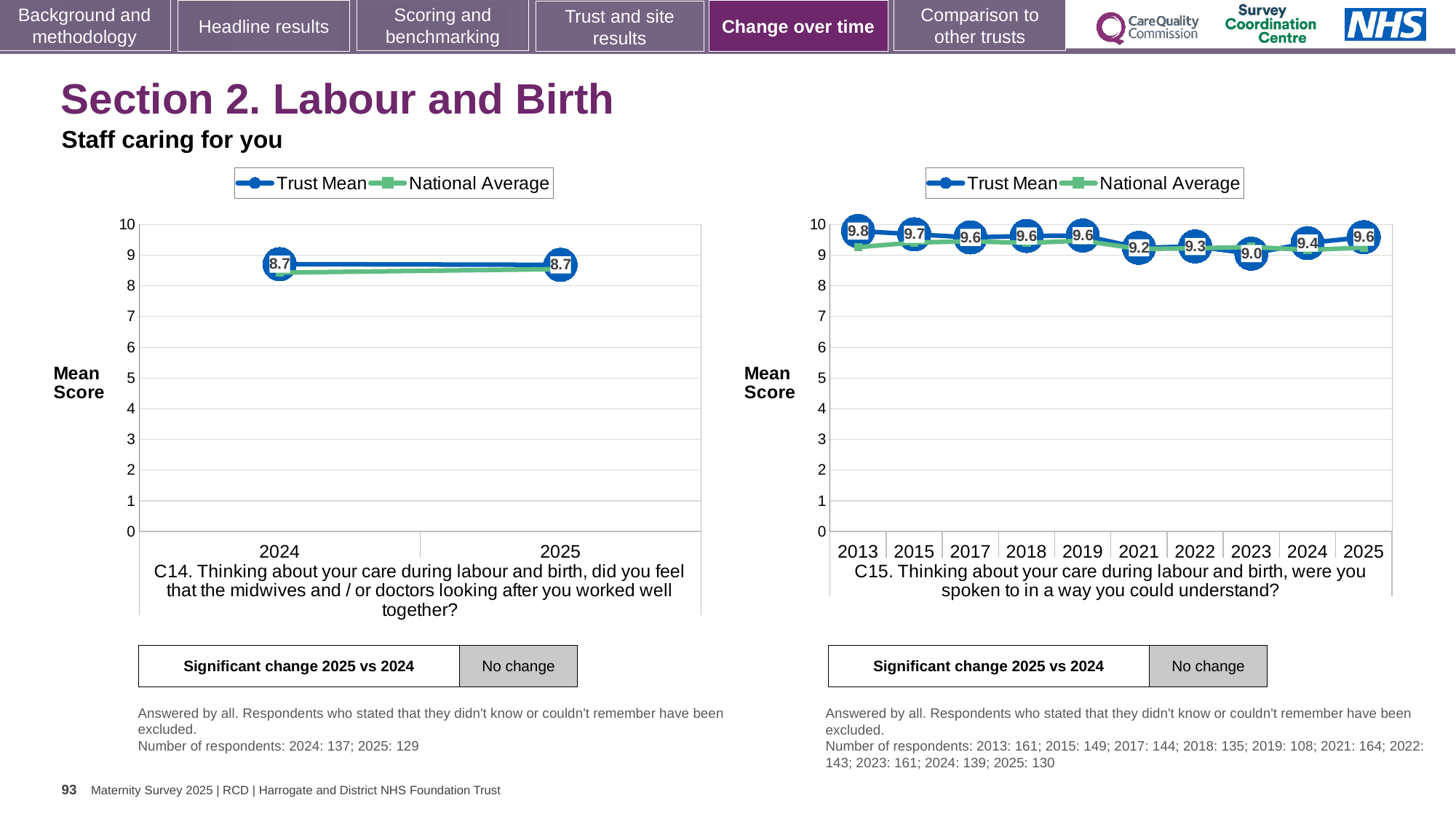
What type of chart is the C15 chart on the right? Line chart In the C15 chart on the right, is the Trust Mean score higher in 2021 or 2024? 2024 How many series does the legend of the C14 chart on the left list? 2 In the C15 chart on the right, what is the Trust Mean score for 2013? 9.8 In the C15 chart on the right, which year has the lowest Trust Mean score? 2023 In the C15 chart on the right, which year has the highest Trust Mean score? 2013 How many years are plotted on the x axis of the C15 chart on the right? 10 In the C14 chart on the left, what is the Trust Mean score for 2024? 8.7 In the C15 chart on the right, what is the difference between the Trust Mean scores for 2013 and 2023? 0.8 In the C15 chart on the right, what is the Trust Mean score for 2025? 9.6 In the C14 chart on the left, what is the Trust Mean score for 2025? 8.7 In the C15 chart on the right, what is the Trust Mean score for 2023? 9.0